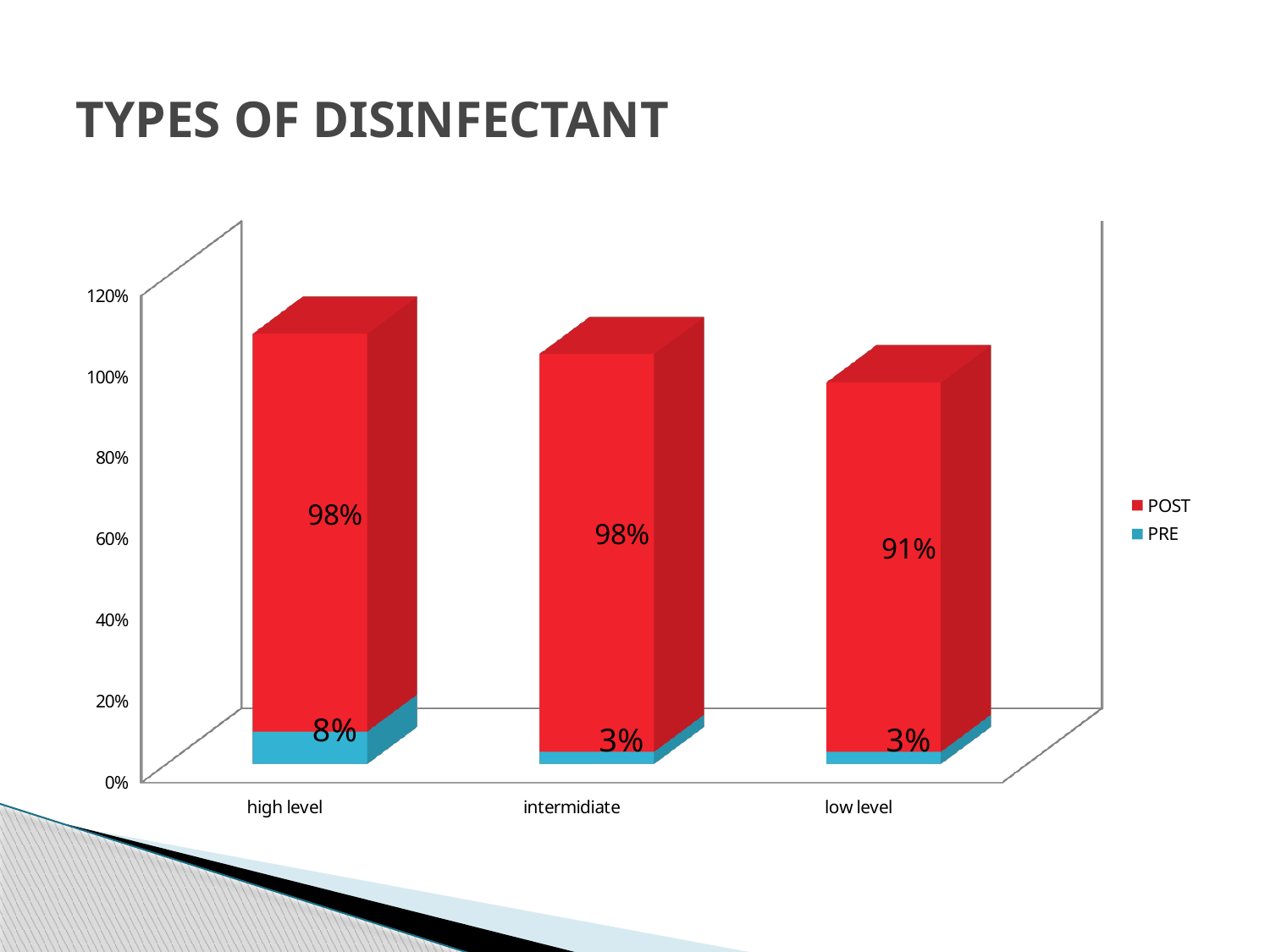
What is the POST value for high level? 98% Is the POST value for high level larger or smaller than the POST value for low level? larger What is the total of the stacked bar for high level? 106% What is the PRE value for low level? 3% What is the difference between the POST and PRE values for intermidiate? 95% What is the PRE value for high level? 8% How many categories are shown on the x axis? 3 What kind of chart is shown on the slide? stacked bar chart What is the POST value for low level? 91% Which category has the highest PRE value? high level How many series does the legend list? 2 Which category has the lowest POST value? low level